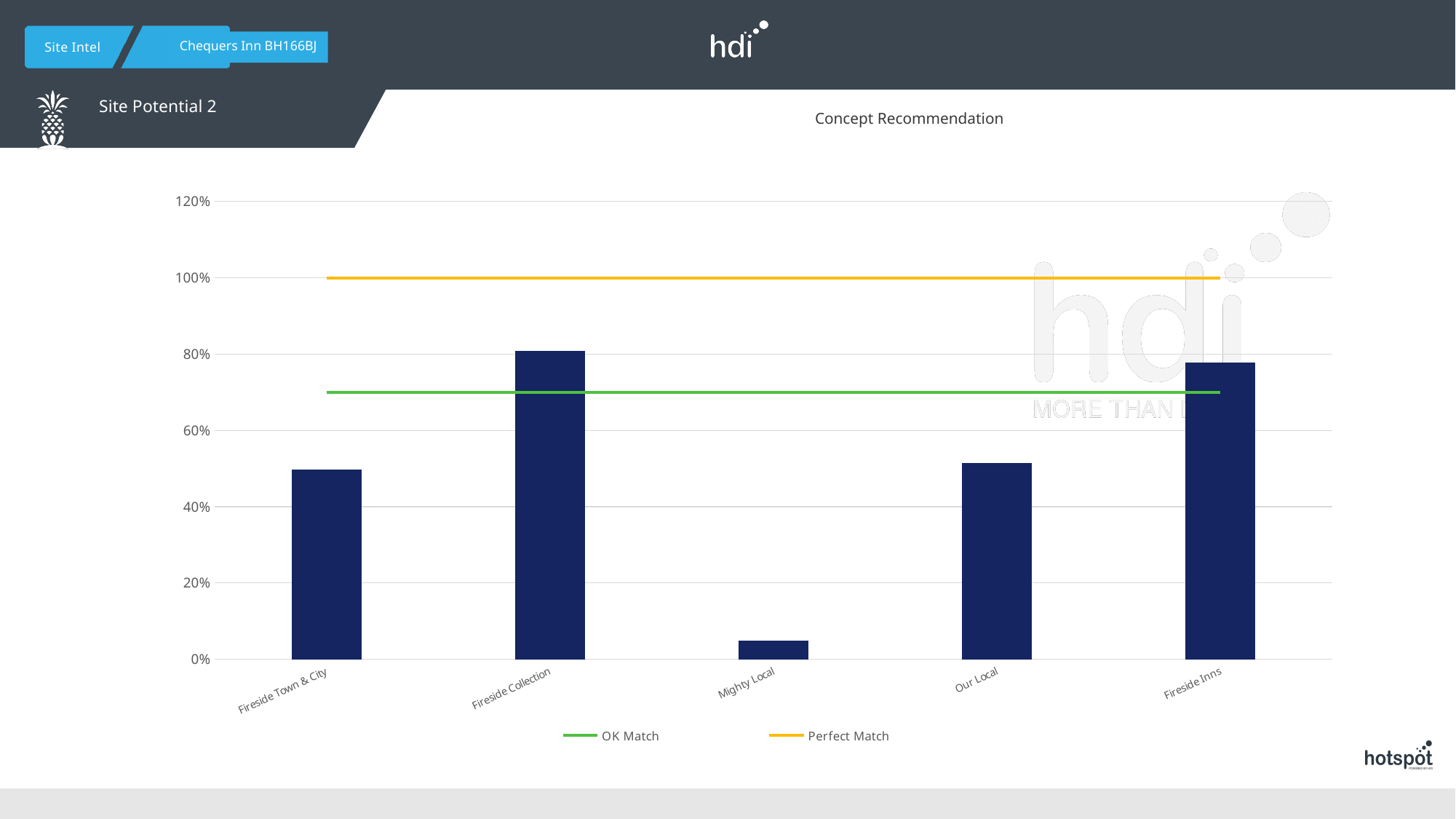
Is the value for Fireside Inns greater or less than 80%? less How many entries does the chart's legend list? 2 Which category has the highest bar in the chart? Fireside Collection What is the title shown above the chart? Concept Recommendation Which is larger, the value for Our Local or the value for Mighty Local? Our Local How many categories are shown on the x axis of the chart? 5 Is the value for Mighty Local greater or less than 20%? less What kind of chart is shown on the slide? bar chart At what level does the Perfect Match line sit on the chart? 100% Is the value for Fireside Town & City greater or less than 60%? less Which category has the lowest bar in the chart? Mighty Local